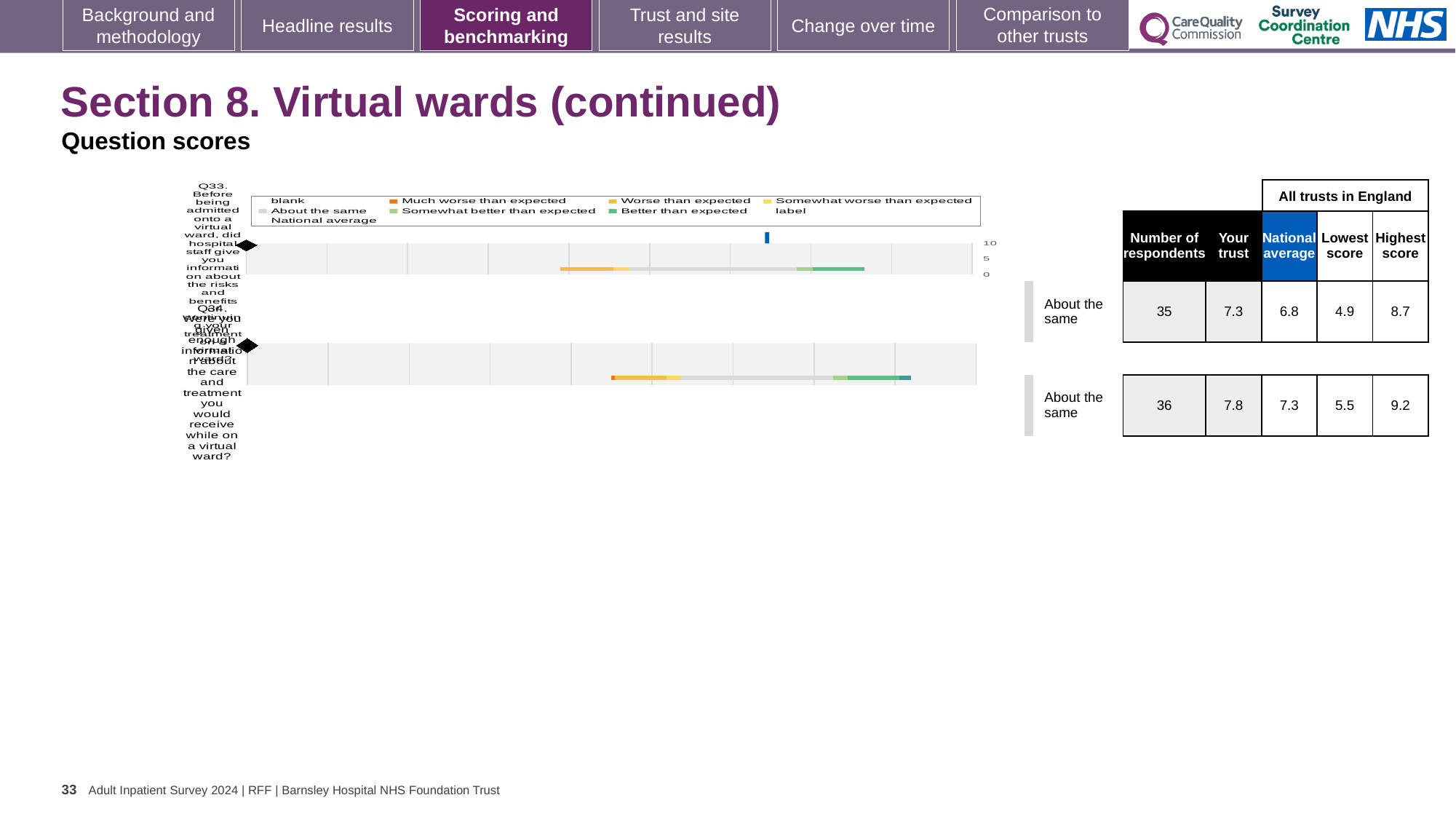
In the table next to the chart, what is the 'Your trust' score for Q33? 7.3 In the table next to the chart, what is the 'Your trust' score for Q34? 7.8 In the table next to the chart, what is the national average for Q34? 7.3 How many questions (categories) are plotted in the chart? 2 Which question has the higher 'Your trust' score, Q33 or Q34? Q34 What is the difference between the 'Your trust' score and the national average for Q33? 0.5 In the table next to the chart, what is the lowest score among all trusts in England for Q34? 5.5 In the table next to the chart, what is the highest score among all trusts in England for Q33? 8.7 What is the maximum value shown on the chart's score axis? 10 How many respondents answered Q34 according to the table next to the chart? 36 What kind of chart is shown on the slide? bar chart